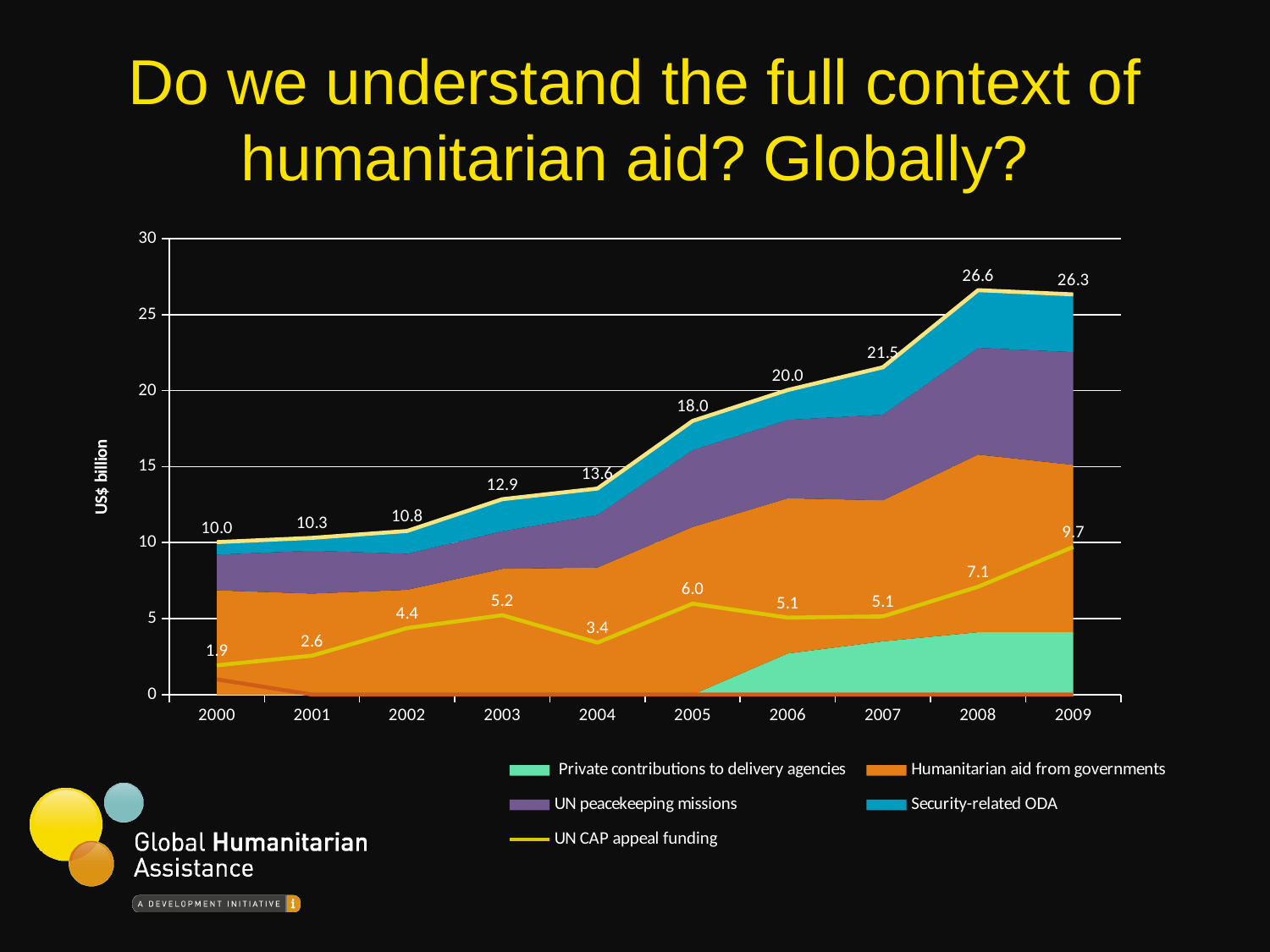
What is the difference between the labelled total for 2009 and the labelled total for 2000? 16.3 By how much did UN CAP appeal funding increase from 2007 to 2008? 2.0 What is the total value labelled for 2008? 26.6 What kind of chart is shown on the slide? combination stacked area and line chart How many years are shown on the x axis? 10 What is the UN CAP appeal funding value for 2004? 3.4 What is the UN CAP appeal funding value for 2009? 9.7 In which year is the labelled total the highest? 2008 Is the labelled total for 2007 greater or less than 20? greater Which year has the higher UN CAP appeal funding, 2004 or 2005? 2005 In which year is UN CAP appeal funding the lowest? 2000 How many series does the legend list? 5